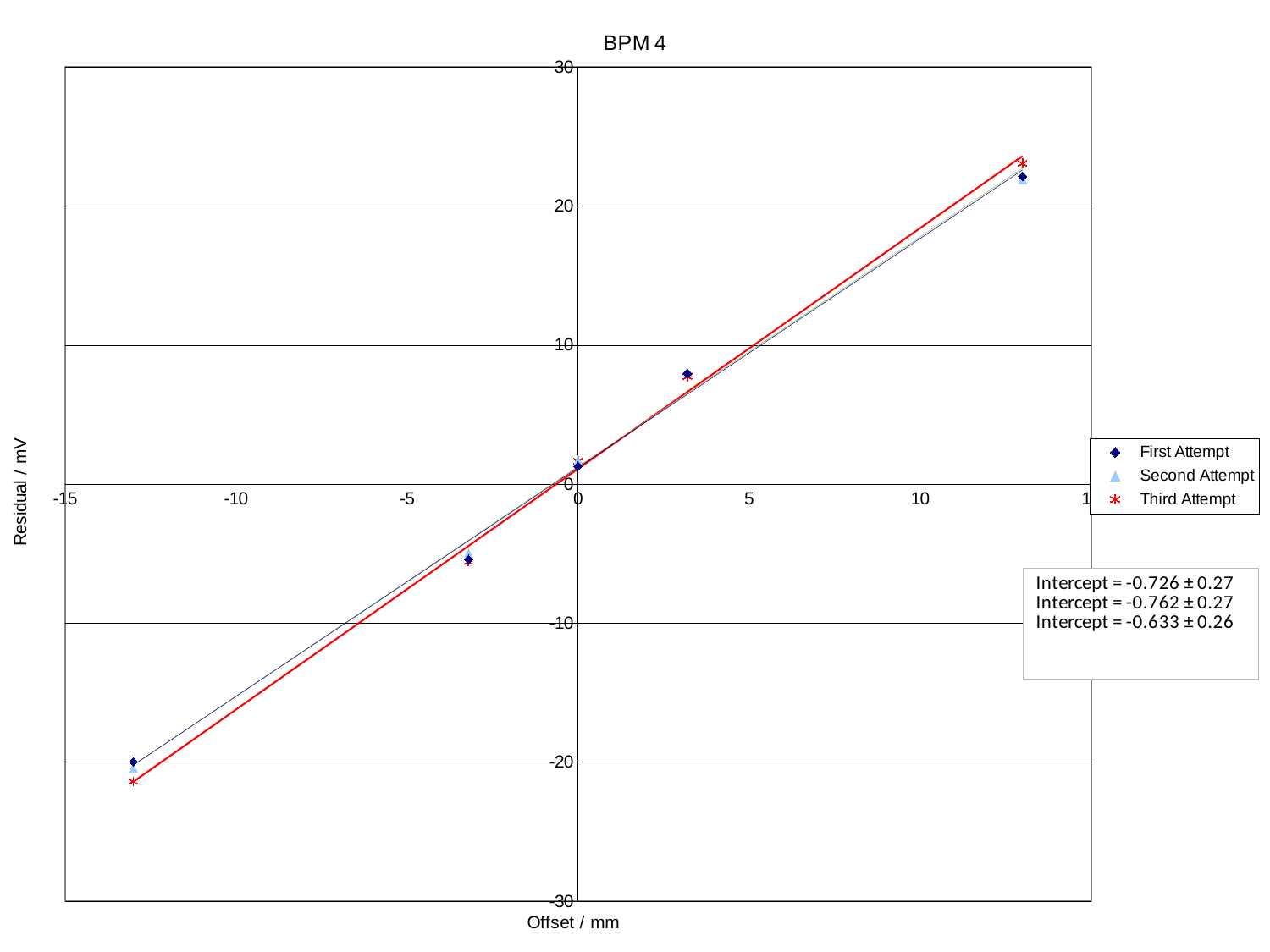
Is the First Attempt value at an offset of about -13 mm greater or less than -10? less At an offset of about 13 mm, which series has the larger value, First Attempt or Third Attempt? Third Attempt Is the First Attempt value at an offset of about 3 mm greater or less than 10? less What is the title of the chart? BPM 4 What kind of chart is shown on the slide? Scatter chart Is the Third Attempt value at an offset of about 13 mm greater or less than 20? greater Do the Residual values rise or fall as Offset increases along the x axis? Rise How many series does the legend list? 3 Which series is plotted with red asterisk markers? Third Attempt At an offset of about -13 mm, which series has the lower value, First Attempt or Third Attempt? Third Attempt What is the label of the x axis? Offset / mm How many data points are plotted for the First Attempt series? 5